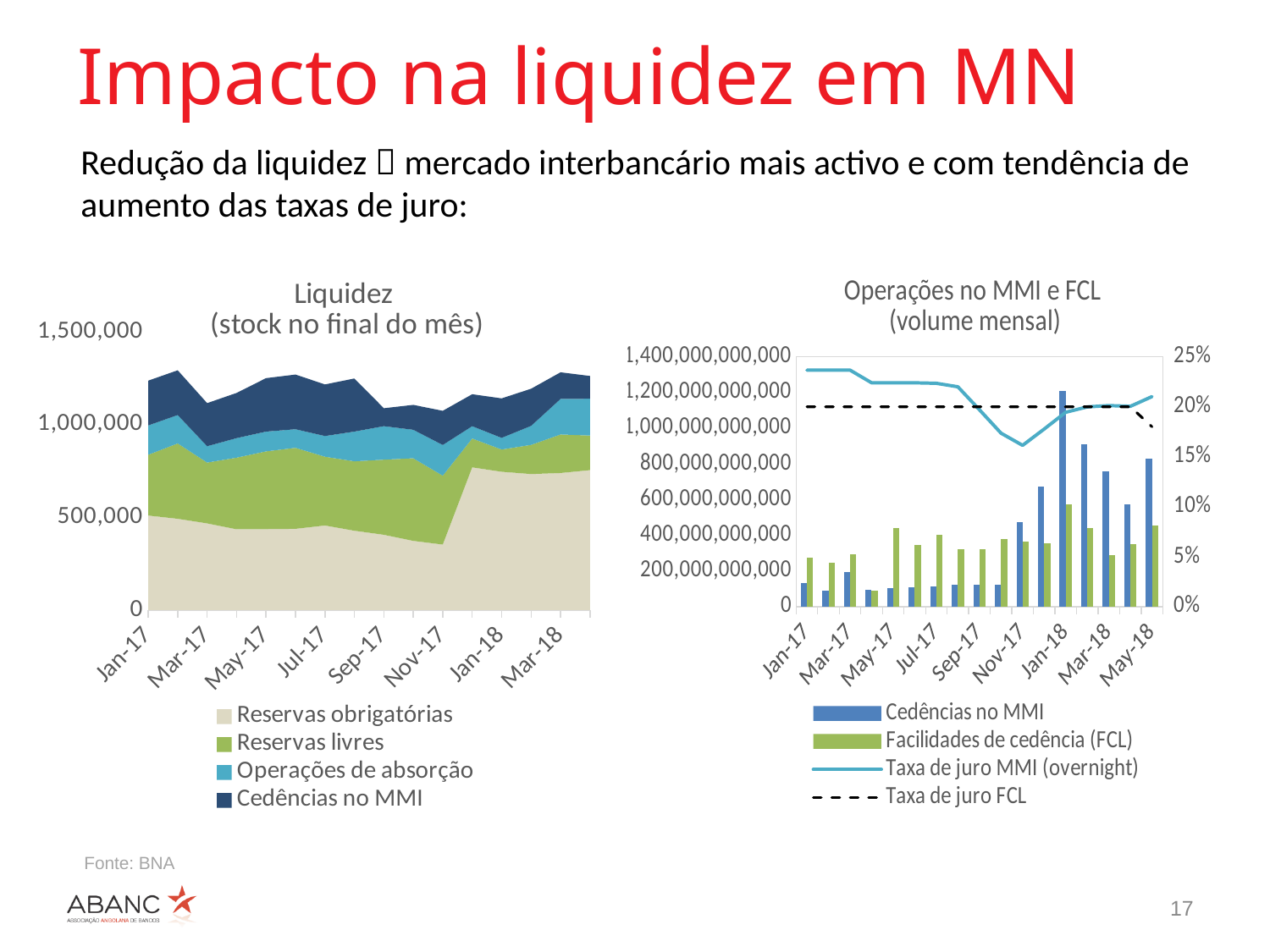
How many series does the legend of the right chart 'Operações no MMI e FCL' list? 4 In the right chart 'Operações no MMI e FCL', in which month is the Cedências no MMI bar the tallest? Jan-18 In the left chart 'Liquidez', is the total stacked value for Jan-17 greater or less than 1,000,000? greater In the left chart 'Liquidez', does the Reservas obrigatórias layer rise or fall between Nov-17 and Jan-18? rise In the right chart 'Operações no MMI e FCL', is the Cedências no MMI value for Jan-18 greater or less than 1,000,000,000,000? greater In the right chart 'Operações no MMI e FCL', which series is drawn as a dashed line? Taxa de juro FCL In the left chart 'Liquidez', which series is shown in the bottom (beige) layer of the stack? Reservas obrigatórias In the right chart 'Operações no MMI e FCL', does the Taxa de juro MMI (overnight) rise or fall between Jan-17 and Nov-17? fall How many series does the legend of the left chart 'Liquidez' list? 4 What kind of chart is the left chart titled 'Liquidez (stock no final do mês)'? stacked area chart In the right chart 'Operações no MMI e FCL', is the Taxa de juro MMI (overnight) in Nov-17 greater or less than 20%? less